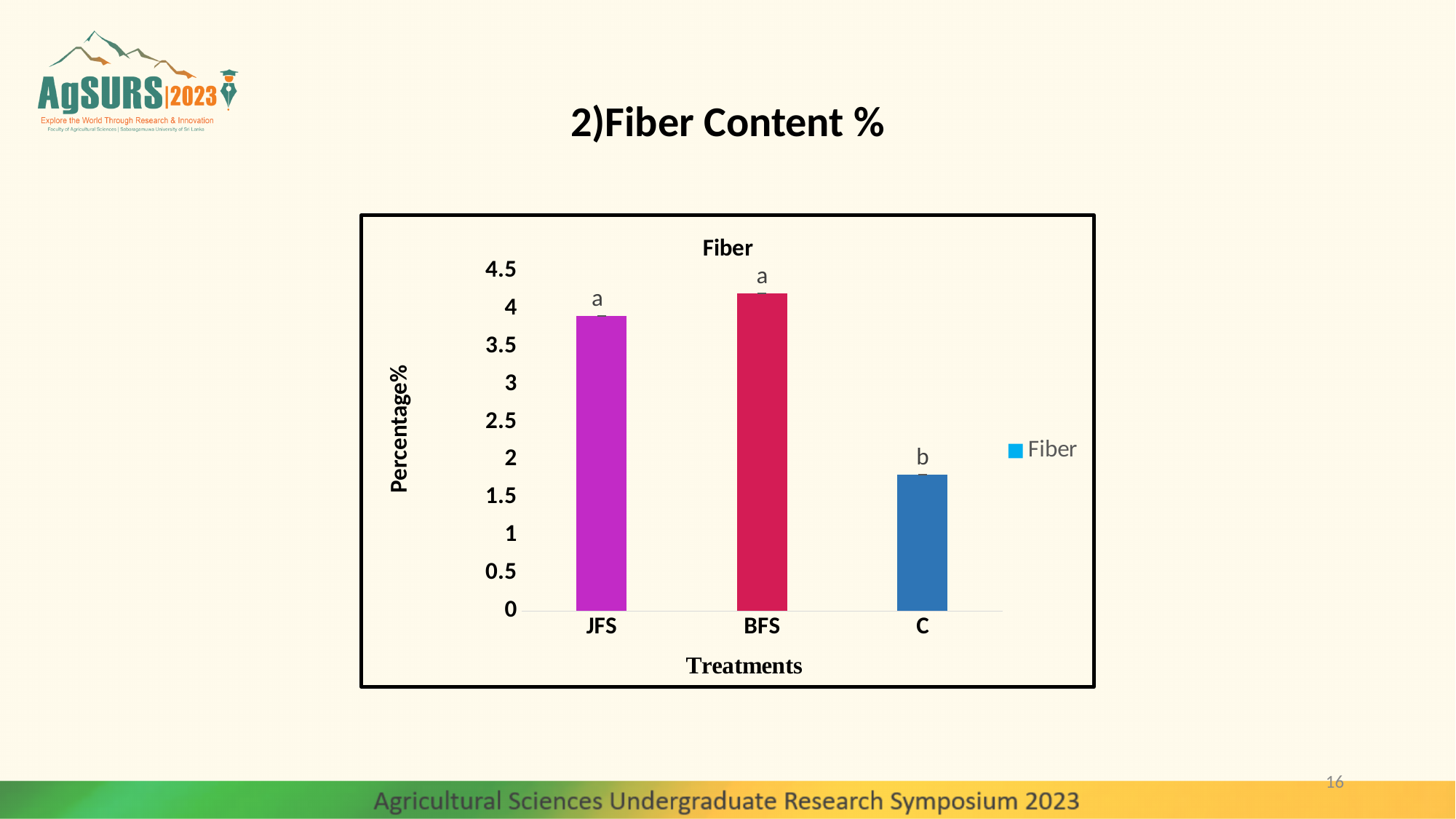
What is the title of the chart? Fiber Which treatment is marked with the letter b above its bar? C Which treatment has the highest fiber content? BFS Is the fiber content for JFS greater or less than 4? less Is the fiber content for C greater or less than 2? less How many treatments are shown on the x axis? 3 Which has a higher fiber content, JFS or C? JFS What is the label of the y axis? Percentage% Which treatment has the lowest fiber content? C What type of chart is shown on the slide? bar chart Is the fiber content for BFS greater or less than 4? greater How many series does the legend list? 1